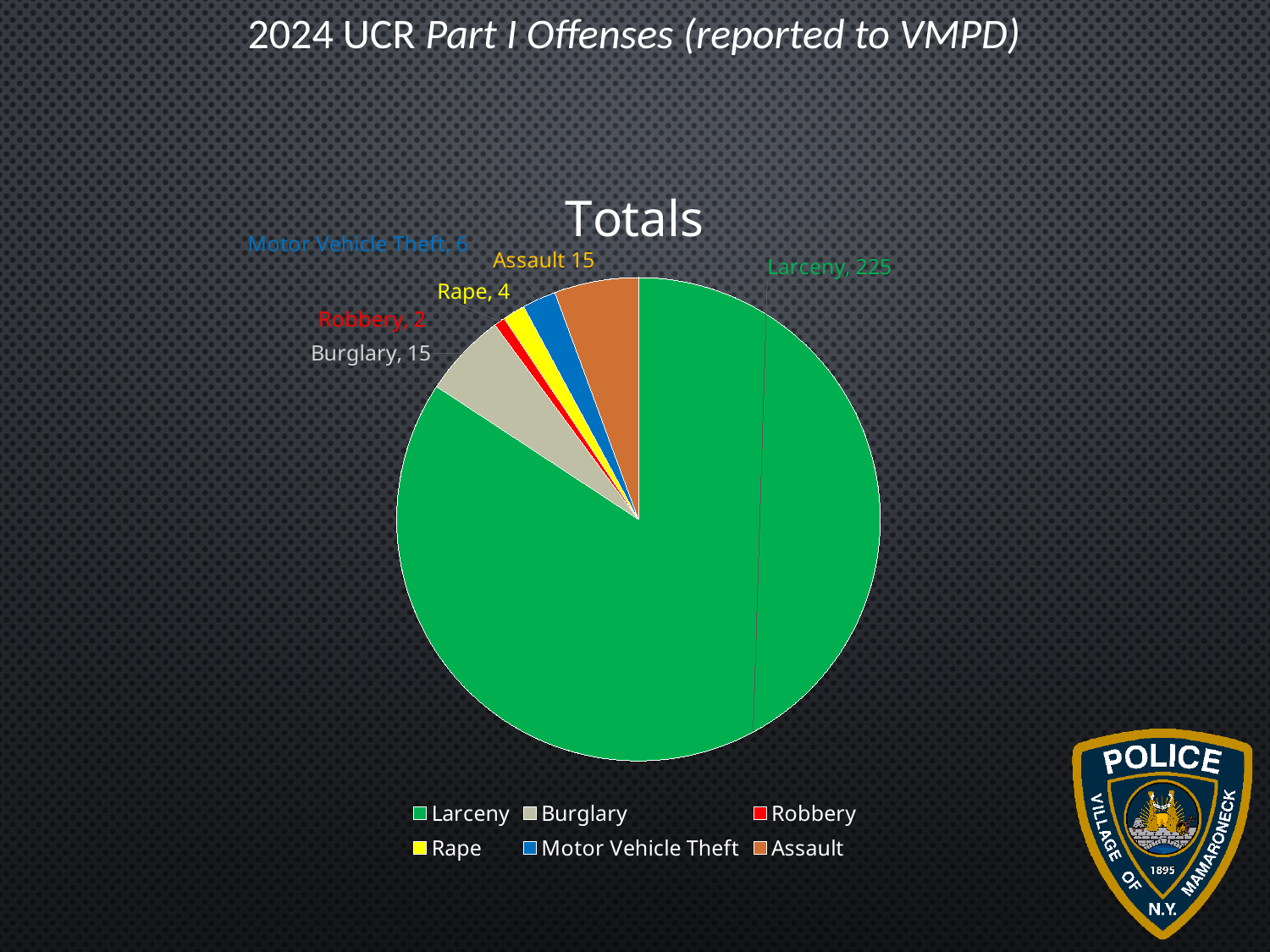
What is the value for Burglary in the pie chart? 15 Which offense category has the smallest slice of the pie? Robbery What is the difference between the Motor Vehicle Theft value and the Robbery value? 4 What is the difference between the Larceny value and the Assault value? 210 What is the value for Motor Vehicle Theft in the pie chart? 6 Which is larger, the value for Rape or the value for Motor Vehicle Theft? Motor Vehicle Theft How many offense categories are shown in the pie chart? 6 Which offense category has the largest slice of the pie? Larceny What type of chart is shown on the slide? Pie chart What is the value for Rape in the pie chart? 4 What is the title of the pie chart? Totals What is the value for Larceny in the pie chart? 225